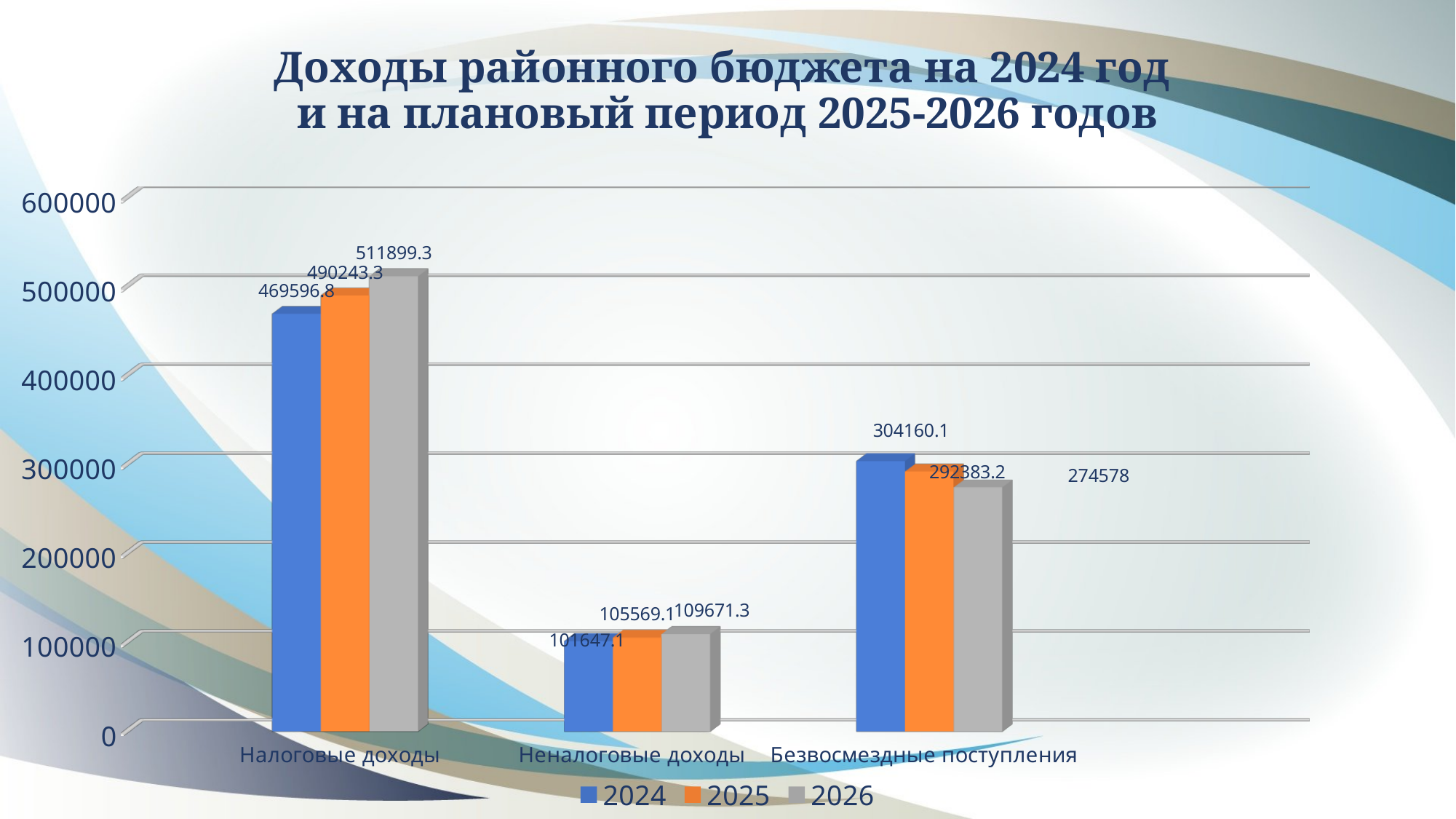
What is the value for Неналоговые доходы in 2025? 105569.1 Which category has the lowest value in 2024? Неналоговые доходы How many series does the legend list? 3 Which is larger for Безвосмездные поступления: the 2024 value or the 2026 value? 2024 What is the difference between the 2026 and 2024 values for Налоговые доходы? 42302.5 What kind of chart is shown on the slide? bar chart How many categories are shown on the x axis? 3 Which category has the highest value in 2025? Налоговые доходы Do the values for Безвосмездные поступления rise or fall from 2024 to 2026? fall What is the value for Налоговые доходы in 2024? 469596.8 What is the value for Безвосмездные поступления in 2026? 274578 What is the value for Налоговые доходы in 2026? 511899.3